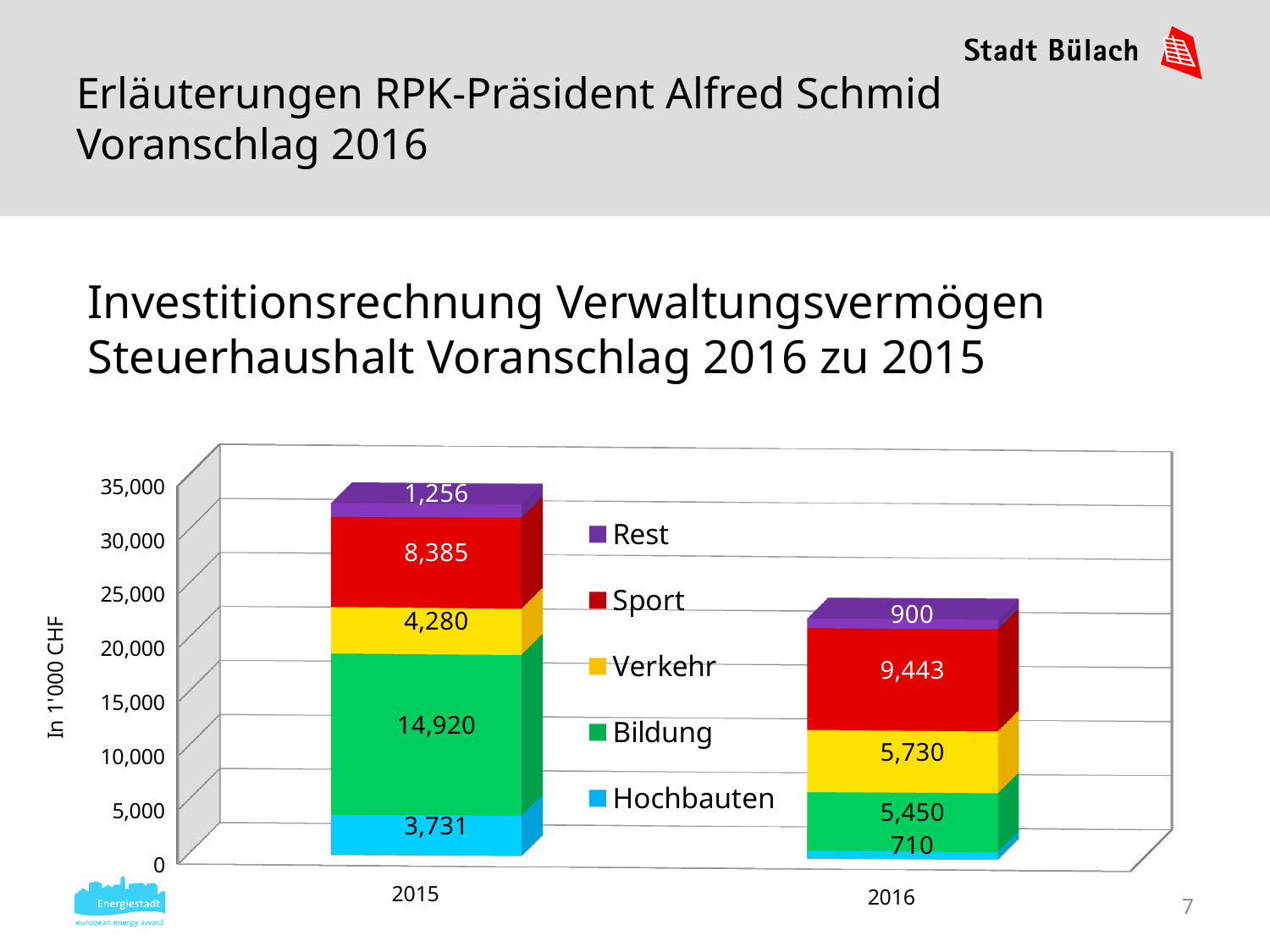
What is the difference between the Bildung values for 2015 and 2016? 9,470 What is the value for Rest in 2015? 1,256 What kind of chart is shown on the slide? Stacked bar chart Which series has the largest value in the 2015 bar? Bildung Which is larger, Verkehr in 2015 or Verkehr in 2016? Verkehr in 2016 What is the difference between the Sport values for 2016 and 2015? 1,058 What is the value for Sport in 2016? 9,443 What is the value for Bildung in 2015? 14,920 What is the total of the stacked bar for 2016? 22,233 What is the value for Hochbauten in 2016? 710 How many series does the legend list? 5 Which series has the smallest value in the 2016 bar? Hochbauten